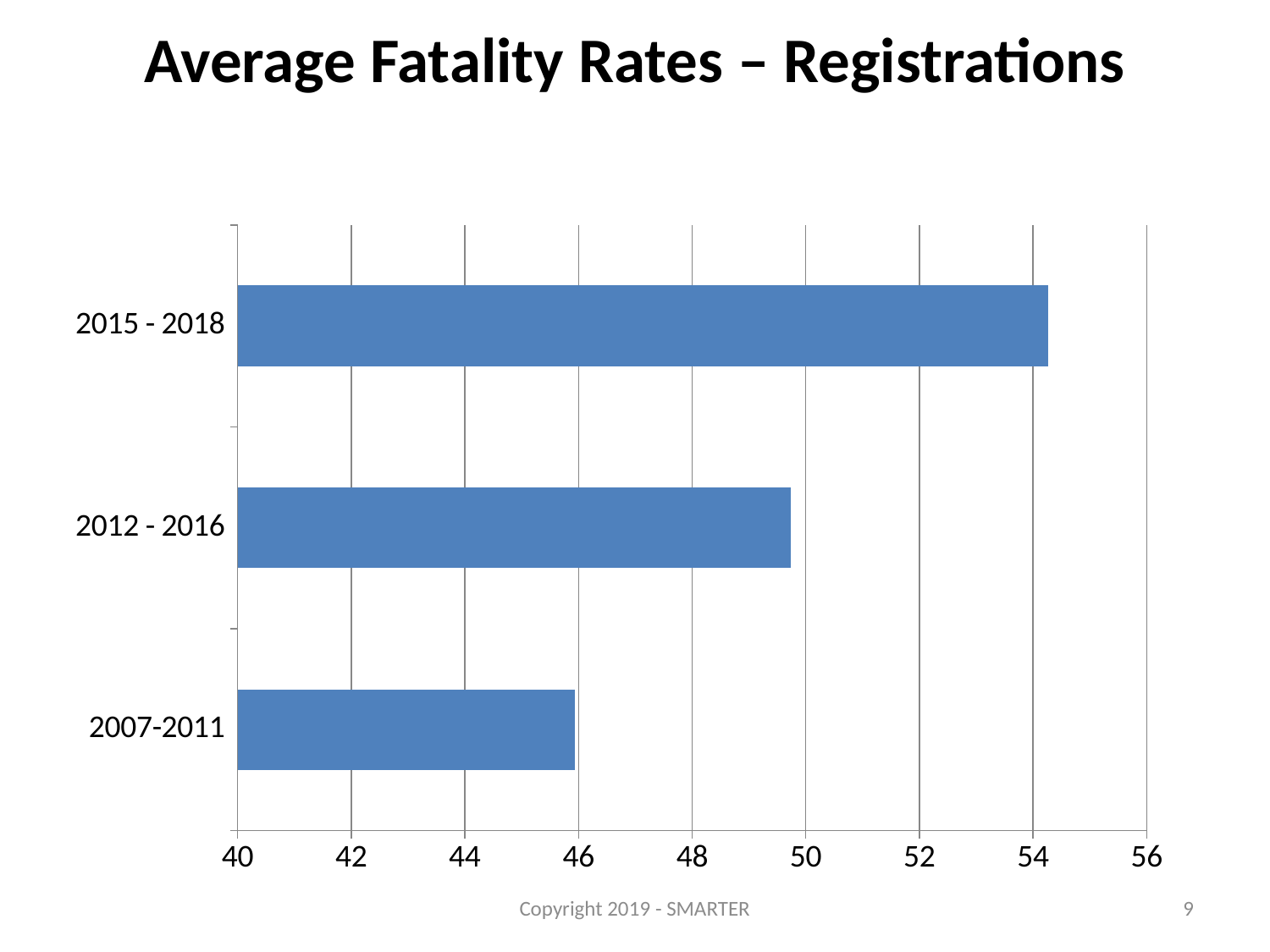
Do the average fatality rates rise or fall from the 2007-2011 period to the 2015 - 2018 period? rise Which time period has the lowest average fatality rate? 2007-2011 What is the title of the chart? Average Fatality Rates – Registrations What is the highest value shown on the horizontal axis? 56 Which time period has the highest average fatality rate? 2015 - 2018 Is the value for 2012 - 2016 greater or less than 48? greater Is the value for 2015 - 2018 greater or less than 52? greater Is the value for 2007-2011 greater or less than 48? less How many categories (time periods) are plotted in the chart? 3 Which has the larger value, 2015 - 2018 or 2012 - 2016? 2015 - 2018 What kind of chart is shown on the slide? bar chart Which has the larger value, 2007-2011 or 2012 - 2016? 2012 - 2016